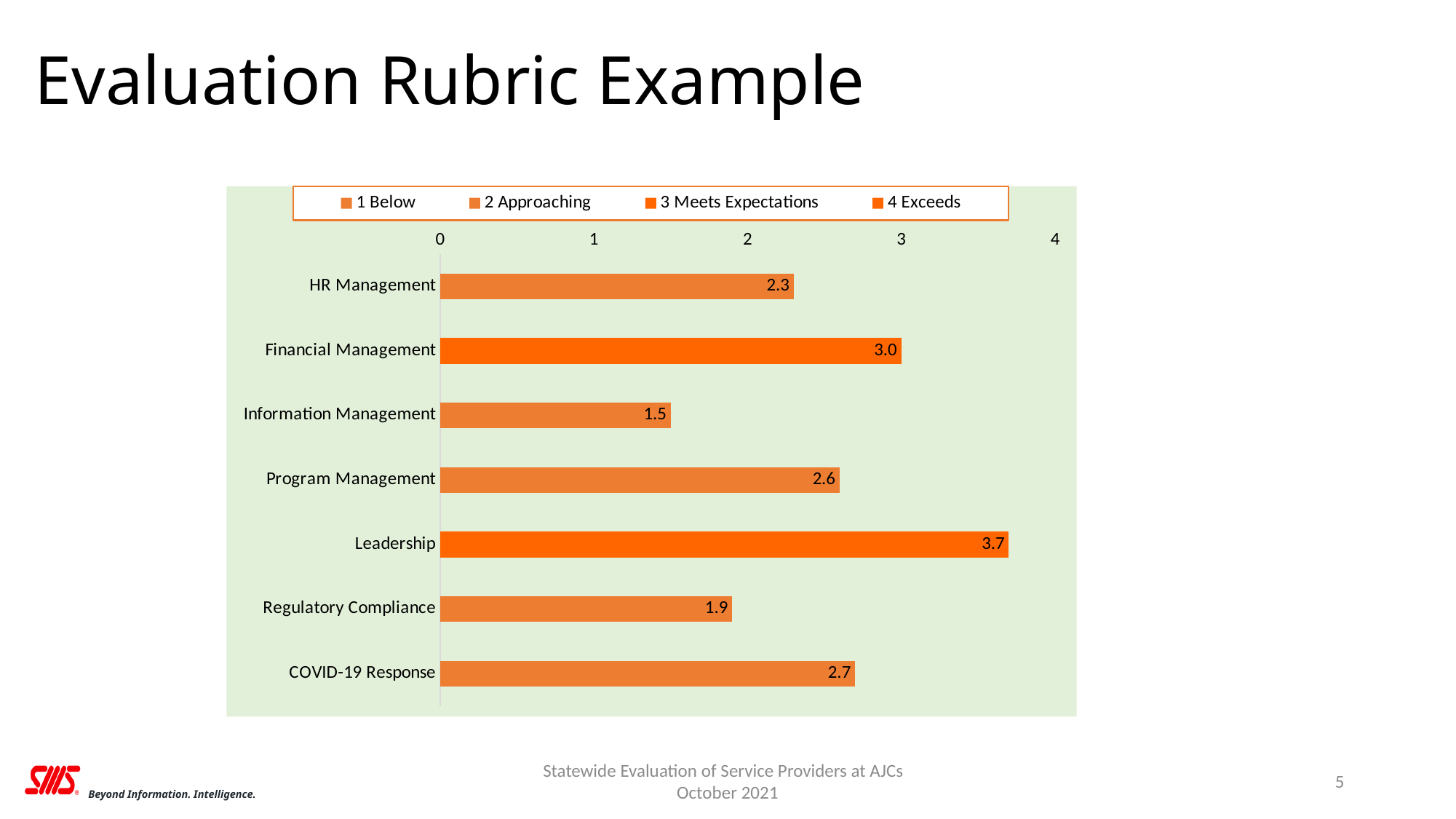
How many categories are shown on the chart? 7 What is the value for Leadership? 3.7 Which category has the highest value? Leadership What is the difference between the values for Leadership and Information Management? 2.2 Is the value for Regulatory Compliance greater or less than 2? less What is the last entry listed in the legend? 4 Exceeds Which category has the lowest value? Information Management What kind of chart is shown on the slide? bar chart How many entries does the legend list? 4 What is the value for Information Management? 1.5 Which is larger, the value for COVID-19 Response or the value for HR Management? COVID-19 Response What is the value for Financial Management? 3.0